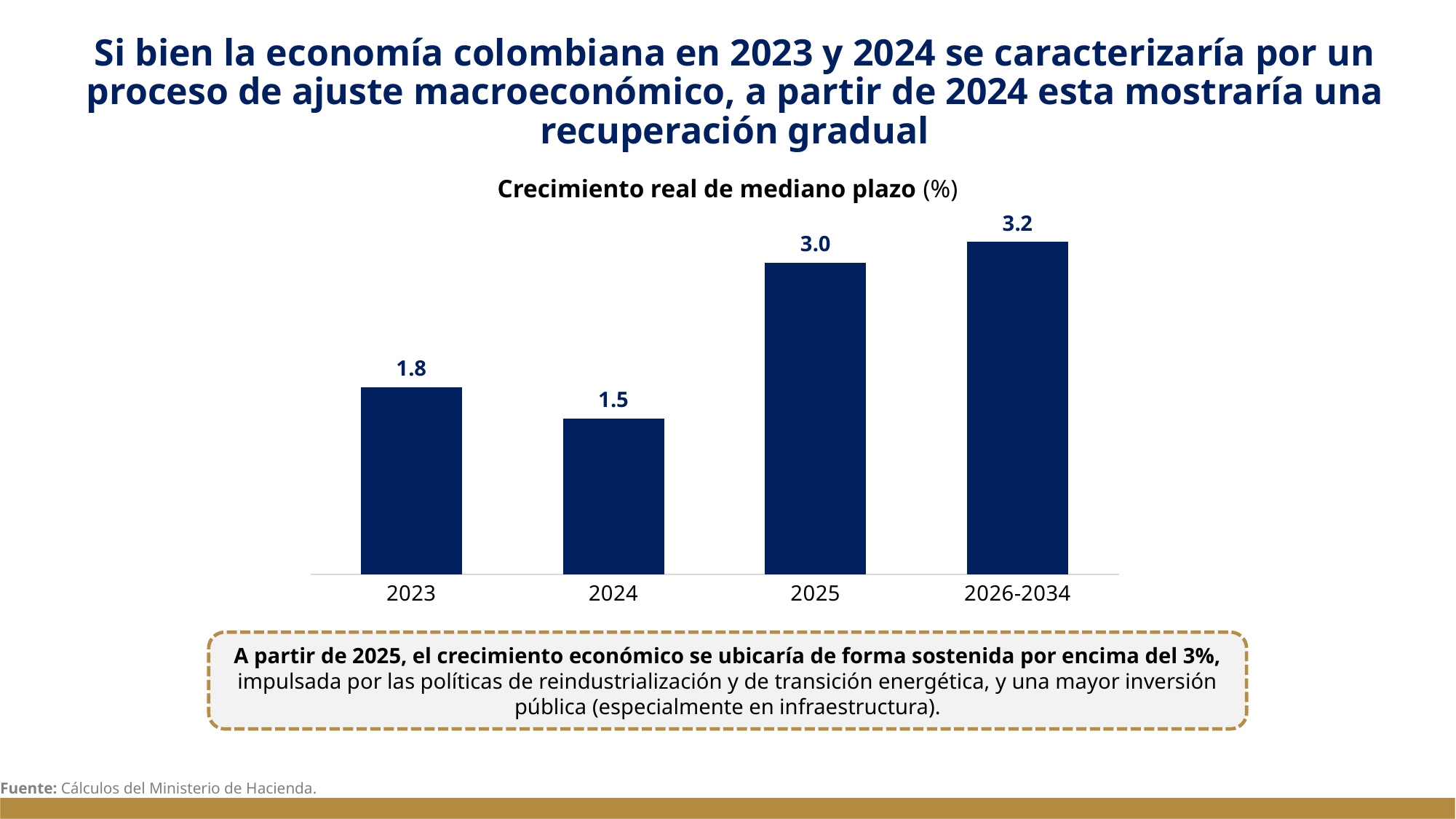
What is the difference between the values for 2025 and 2024? 1.5 What is the value for 2023? 1.8 What is the value for 2025? 3.0 Which category has the lowest value? 2024 Which category has the highest value? 2026-2034 What is the value for 2026-2034? 3.2 Which is larger, the value for 2023 or the value for 2024? 2023 What is the value for 2024? 1.5 What kind of chart is shown on the slide? Bar chart What is the title of the chart? Crecimiento real de mediano plazo (%) What is the difference between the values for 2026-2034 and 2023? 1.4 How many categories are shown on the x axis? 4